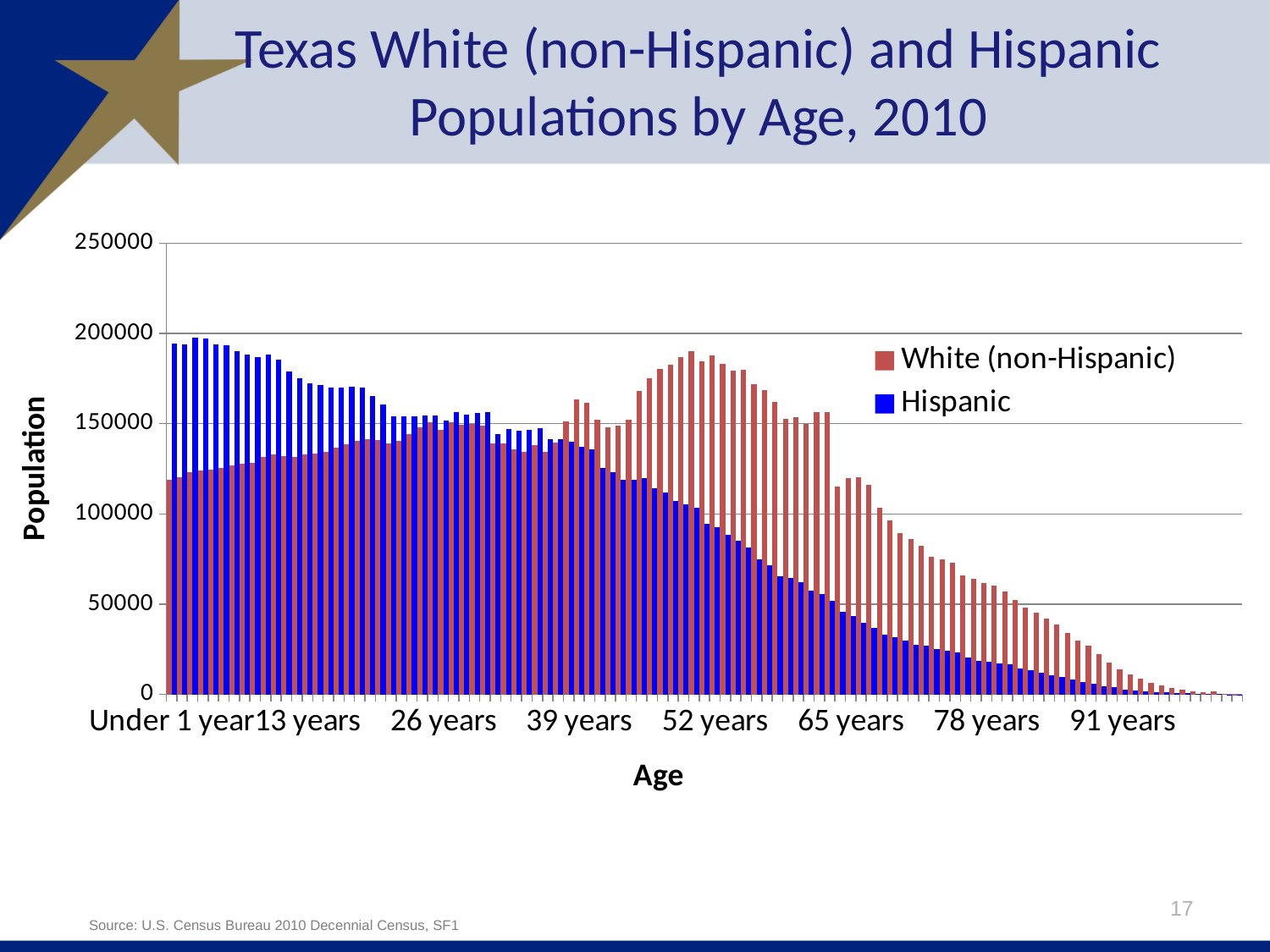
Is the Hispanic value for Under 1 year greater or less than 150000? greater What kind of chart is shown on the slide? bar chart Is the Hispanic value for 78 years greater or less than 50000? less Is the White (non-Hispanic) value for Under 1 year greater or less than 100000? greater Does the Hispanic series generally rise or fall as age increases from 13 years to 91 years? fall At Under 1 year, which series has the larger value, White (non-Hispanic) or Hispanic? Hispanic What is the title of the chart? Texas White (non-Hispanic) and Hispanic Populations by Age, 2010 How many series does the legend list? 2 Which colour represents the Hispanic series? blue At 52 years, which series has the larger value, White (non-Hispanic) or Hispanic? White (non-Hispanic)